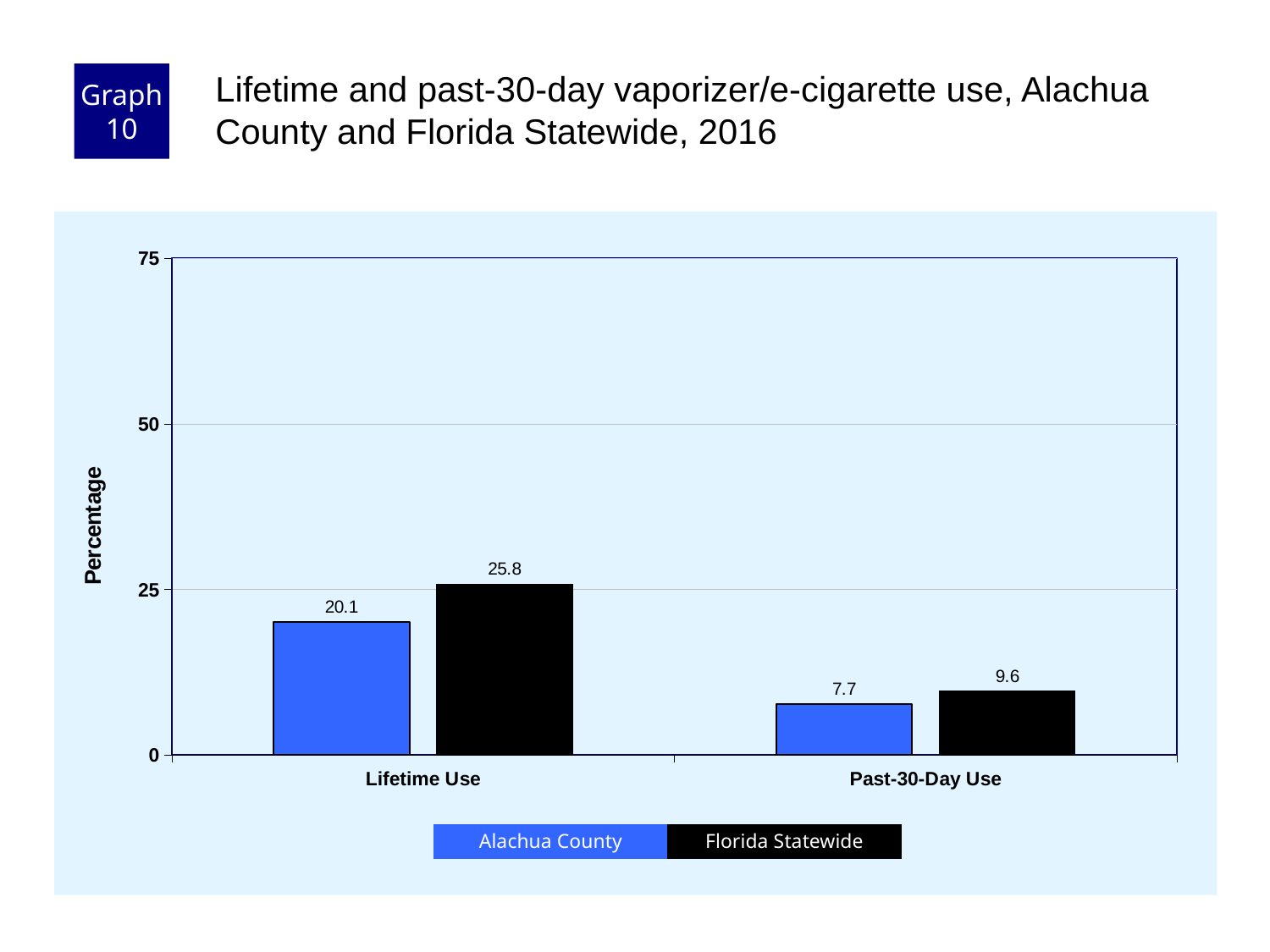
What is the Alachua County value for Lifetime Use? 20.1 What is the difference between the Florida Statewide and Alachua County values for Past-30-Day Use? 1.9 What is the Florida Statewide value for Past-30-Day Use? 9.6 How many series does the legend list? 2 For Past-30-Day Use, which is larger: Alachua County or Florida Statewide? Florida Statewide Is the Florida Statewide value for Lifetime Use greater or less than 25? greater Which bar has the highest value on the chart? Florida Statewide, Lifetime Use What is the Florida Statewide value for Lifetime Use? 25.8 What is the Alachua County value for Past-30-Day Use? 7.7 What is the difference between the Florida Statewide and Alachua County values for Lifetime Use? 5.7 What kind of chart is shown on the slide? bar chart Which bar has the lowest value on the chart? Alachua County, Past-30-Day Use